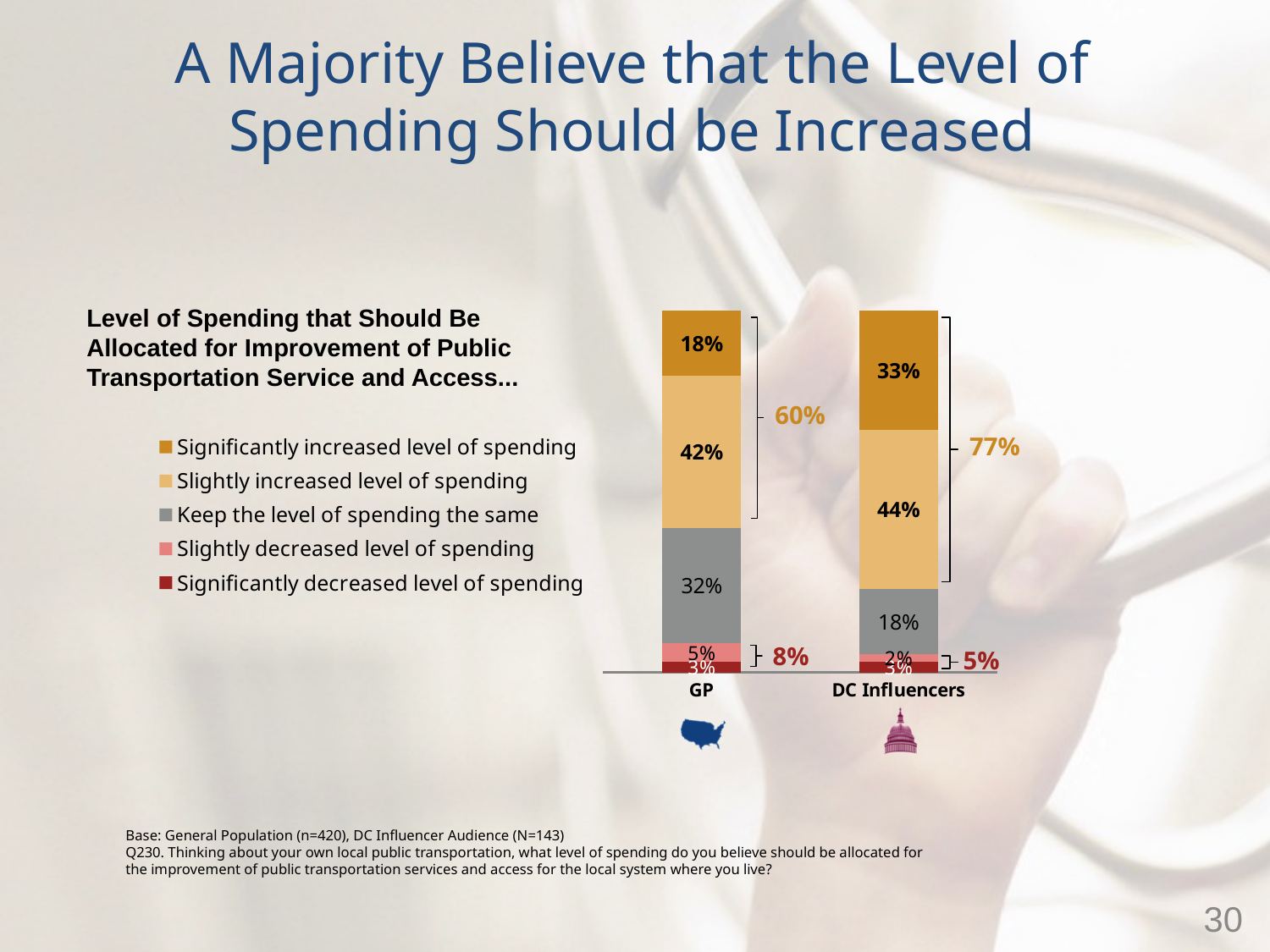
Which group has the larger share choosing 'Significantly increased level of spending', GP or DC Influencers? DC Influencers What is the difference between the 'Keep the level of spending the same' values for GP and DC Influencers? 14 percentage points What percentage of DC Influencers chose 'Significantly increased level of spending'? 33% What kind of chart is shown on the slide? Stacked bar chart How many categories are shown on the x axis? 2 What is the combined share of GP respondents who want increased spending (significantly or slightly), as shown by the bracket? 60% What is the combined share of DC Influencers who want increased spending (significantly or slightly), as shown by the bracket? 77% What percentage of GP respondents chose 'Keep the level of spending the same'? 32% How many series does the legend list? 5 What percentage of DC Influencers chose 'Slightly increased level of spending'? 44% What is the combined share of GP respondents who want decreased spending, as shown by the bracket? 8% What percentage of GP respondents chose 'Significantly increased level of spending'? 18%